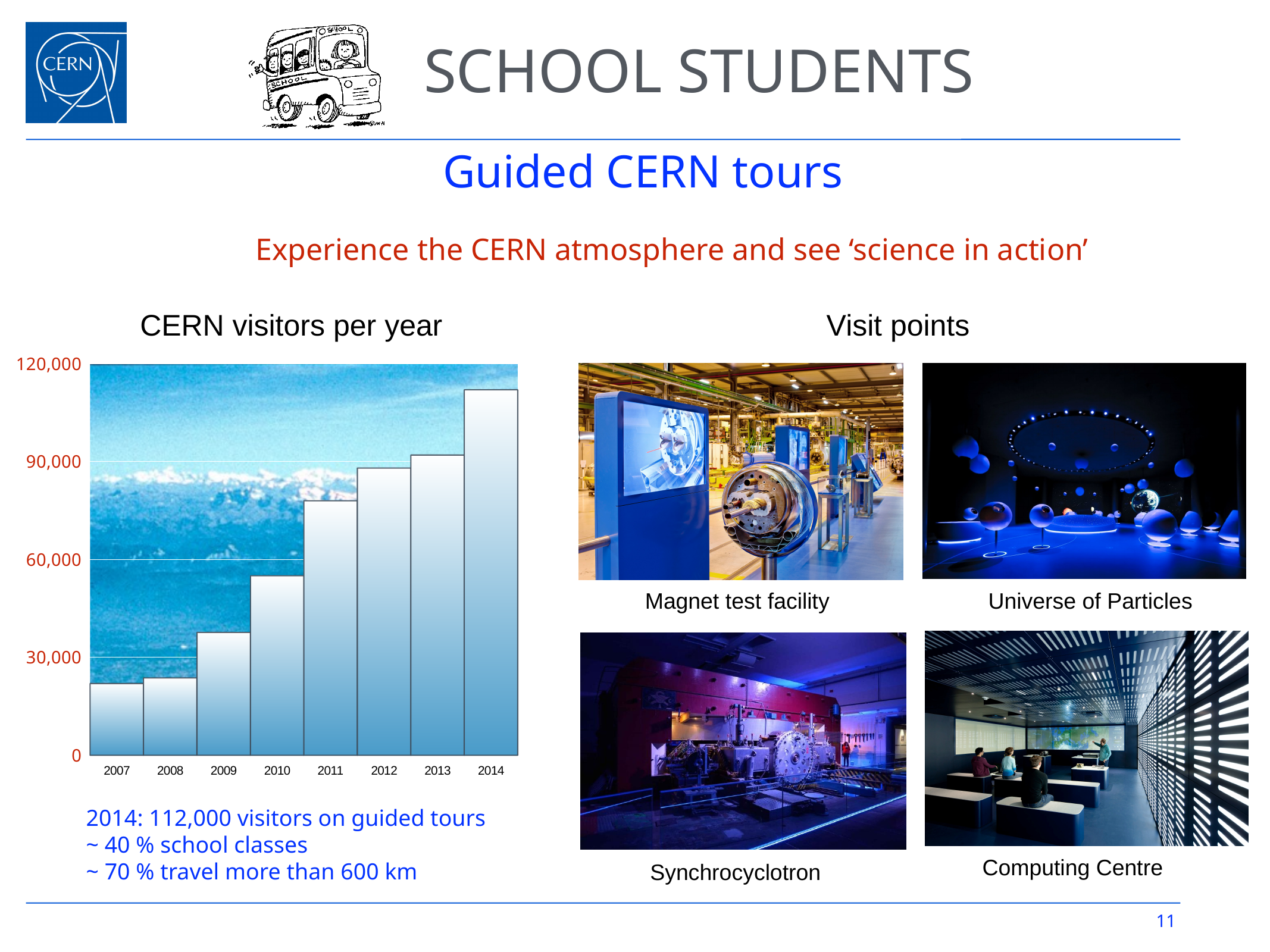
In the "CERN visitors per year" chart, is the value for 2011 greater or less than 60,000? greater Do the values in the "CERN visitors per year" chart rise or fall from 2007 to 2014? rise According to the slide, how many visitors went on guided tours in 2014? 112,000 What is the title of the chart on the left of the slide? CERN visitors per year In the "CERN visitors per year" chart, which year has the highest number of visitors? 2014 In the "CERN visitors per year" chart, is the value for 2014 greater or less than 90,000? greater How many years are shown on the x axis of the "CERN visitors per year" chart? 8 In the "CERN visitors per year" chart, is the value for 2007 greater or less than 30,000? less What kind of chart is shown under the title "CERN visitors per year"? bar chart In the "CERN visitors per year" chart, which year has more visitors, 2010 or 2011? 2011